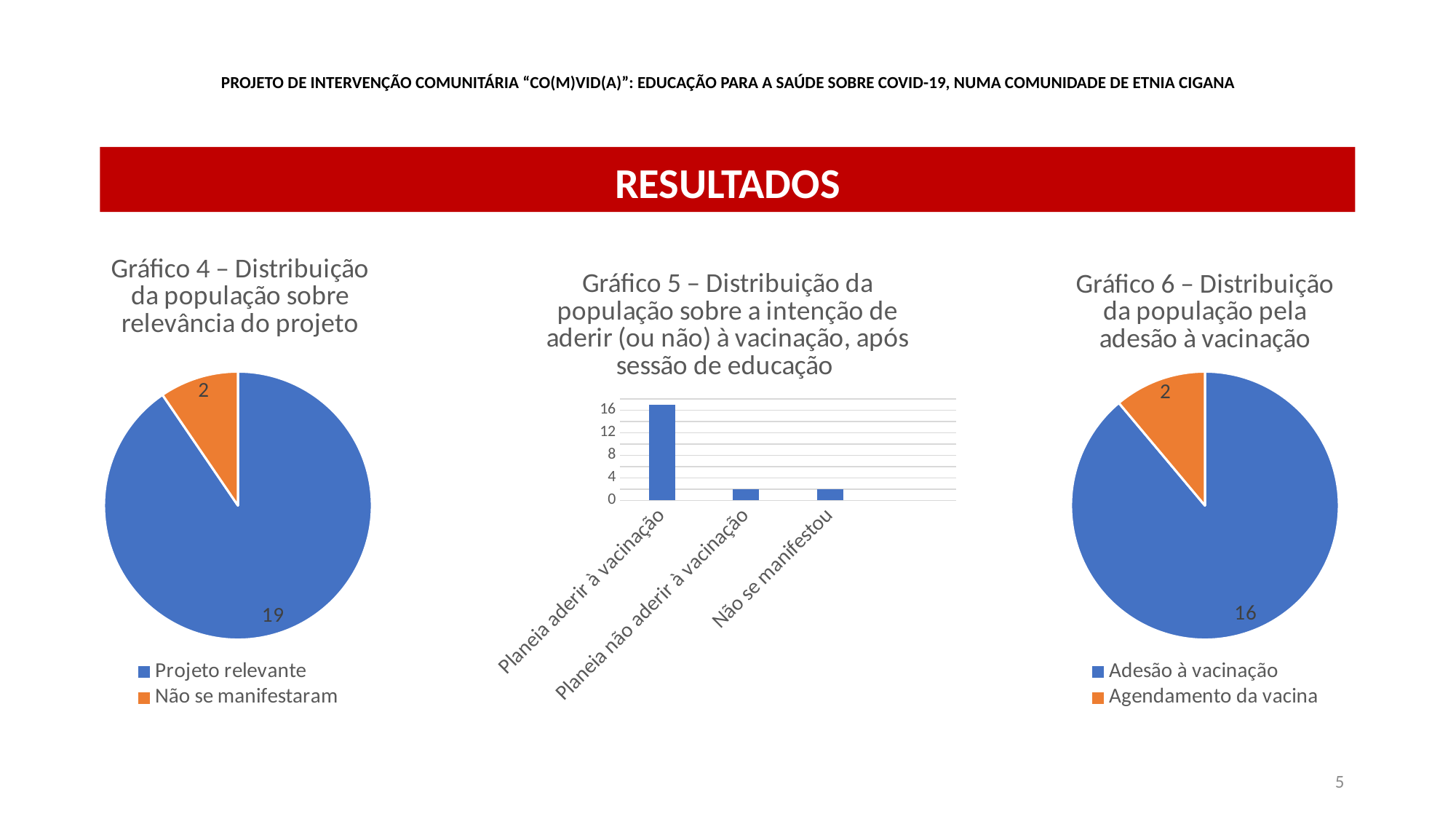
In Gráfico 5, is the value for 'Planeia aderir à vacinação' greater or less than 12? greater In Gráfico 6, what is the value for 'Adesão à vacinação'? 16 In Gráfico 4, how many people considered the project relevant (Projeto relevante)? 19 In Gráfico 5, which category has the highest value? Planeia aderir à vacinação How many categories are shown in Gráfico 5? 3 How many entries does the legend of Gráfico 6 list? 2 In Gráfico 6, which category is larger: 'Adesão à vacinação' or 'Agendamento da vacina'? Adesão à vacinação In Gráfico 4, what is the difference between 'Projeto relevante' and 'Não se manifestaram'? 17 In Gráfico 4, what is the total of the two slices? 21 What kind of chart is Gráfico 5? Bar chart In Gráfico 4, what is the value for 'Não se manifestaram'? 2 In Gráfico 5, is the value for 'Não se manifestou' greater or less than 4? less